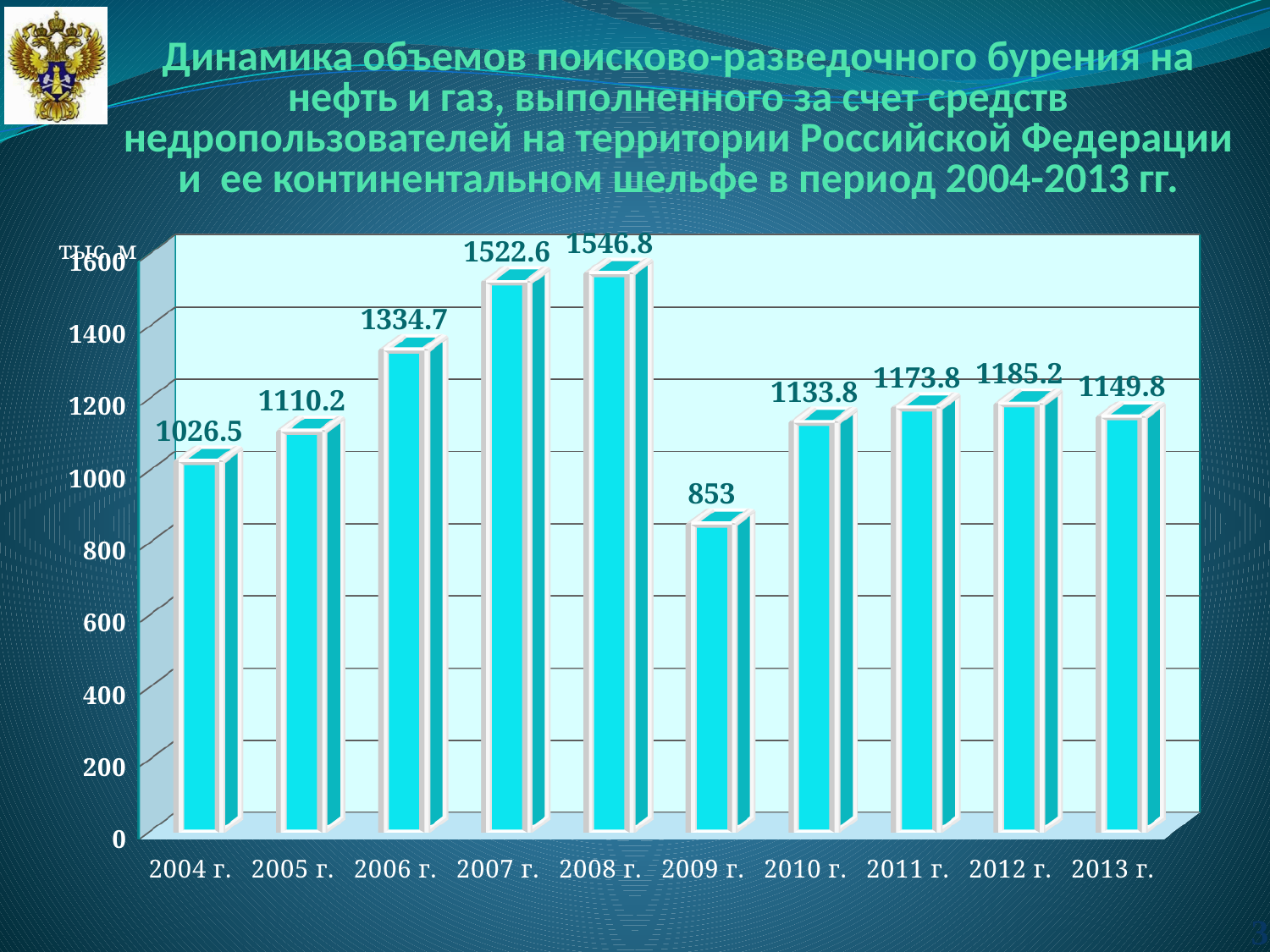
Which is larger, the value for 2006 г. or the value for 2010 г.? 2006 г. Do the values rise or fall from 2004 г. to 2008 г.? rise What is the difference between the values for 2008 г. and 2007 г.? 24.2 Which year has the highest value? 2008 г. What is the value for 2012 г.? 1185.2 What kind of chart is shown on the slide? bar chart What is the value for 2004 г.? 1026.5 What is the difference between the values for 2004 г. and 2009 г.? 173.5 What is the value for 2009 г.? 853 Which year has the lowest value? 2009 г. Is the value for 2009 г. greater or less than 1000? less How many years are shown on the x axis? 10